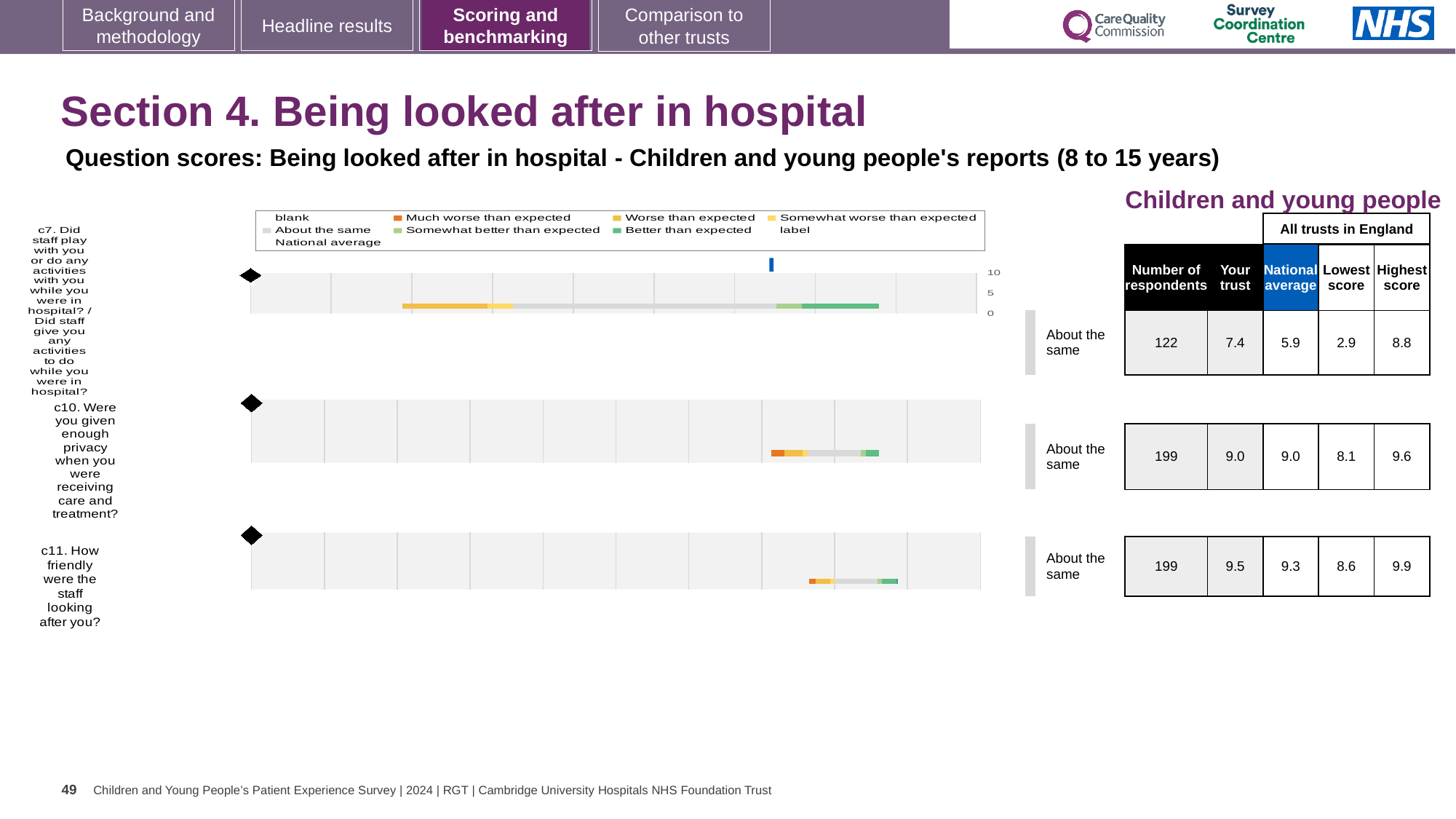
How many entries does the chart legend list? 9 For c11, which is larger: the 'Your trust' score or the national average? Your trust (9.5) What is the national average score for c11 (How friendly were the staff looking after you?)? 9.3 What benchmark category is shown for c7? About the same For c7, what is the difference between the 'Your trust' score and the national average? 1.5 How many respondents answered c7 (Did staff play with you or do any activities with you while you were in hospital?)? 122 How many questions (bars) are plotted on the slide? 3 What kind of chart is used to show the question scores on this slide? Bar chart Which question has the highest 'Your trust' score? c11. How friendly were the staff looking after you? What is the 'Your trust' score for c10 (Were you given enough privacy when you were receiving care and treatment?)? 9.0 What is the highest score among all trusts in England for c10? 9.6 Which question has the lowest 'Your trust' score? c7. Did staff play with you or do any activities with you while you were in hospital?